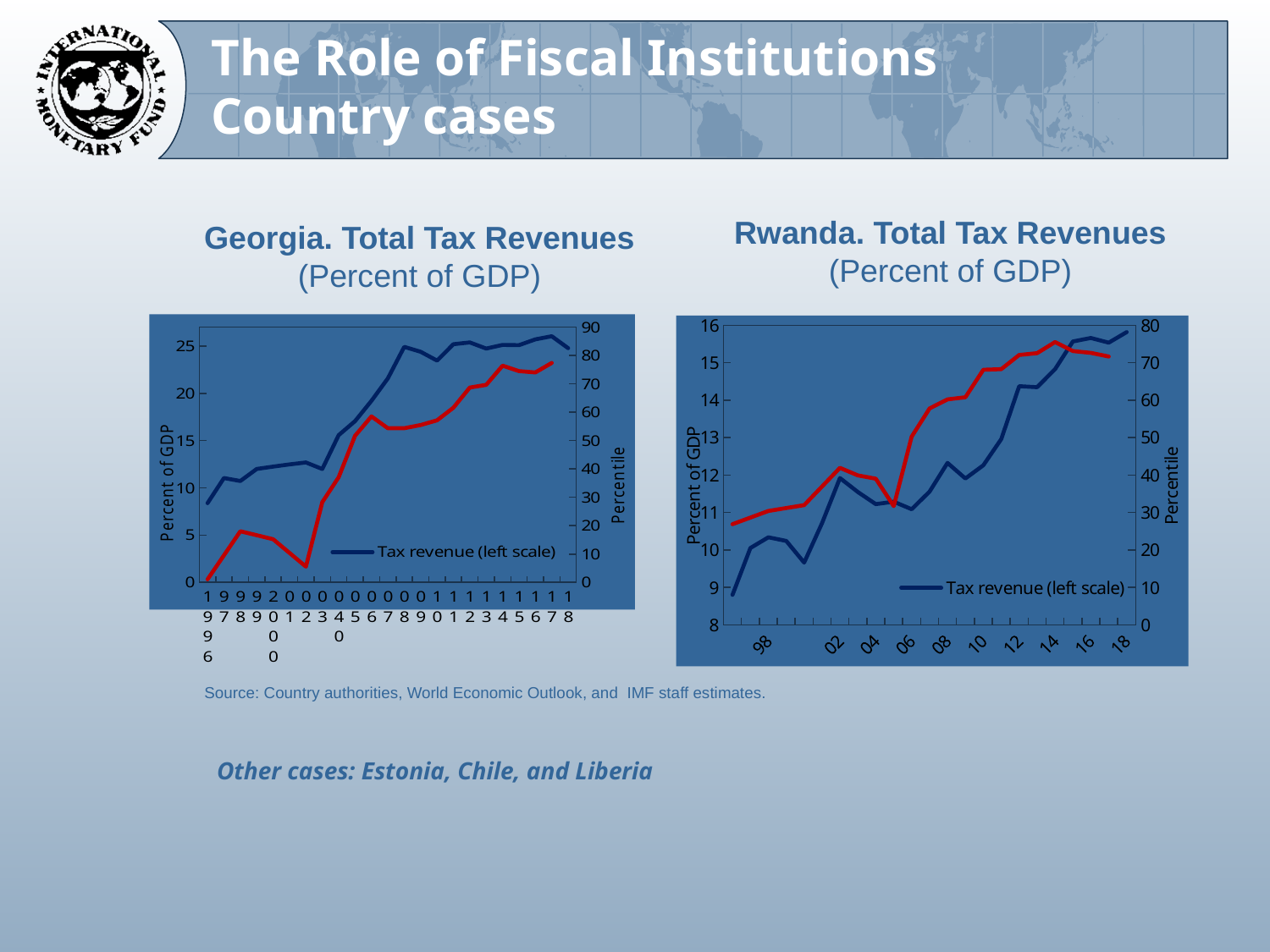
In the Georgia. Total Tax Revenues chart, which year has the larger tax revenue, 1996 or 2018? 2018 In the Georgia. Total Tax Revenues chart, does the tax revenue line generally rise or fall from 1996 to 2018? rise In the Rwanda. Total Tax Revenues chart, does the tax revenue line generally rise or fall across the years shown? rise In the Rwanda. Total Tax Revenues chart, which year has the larger tax revenue, 2002 or 2018? 2018 In the Georgia. Total Tax Revenues chart, is the tax revenue value for 1996 greater or less than 10 percent of GDP? less What kind of chart is the Georgia. Total Tax Revenues chart? line chart In the Rwanda. Total Tax Revenues chart, is the tax revenue value for 2012 greater or less than 13 percent of GDP? greater In the Georgia. Total Tax Revenues chart, is the tax revenue value for 2018 greater or less than 20 percent of GDP? greater What is the label of the right-hand vertical axis on the Georgia. Total Tax Revenues chart? Percentile How many entries does the legend of the Rwanda. Total Tax Revenues chart list? 1 How many years are labelled on the x axis of the Georgia. Total Tax Revenues chart? 23